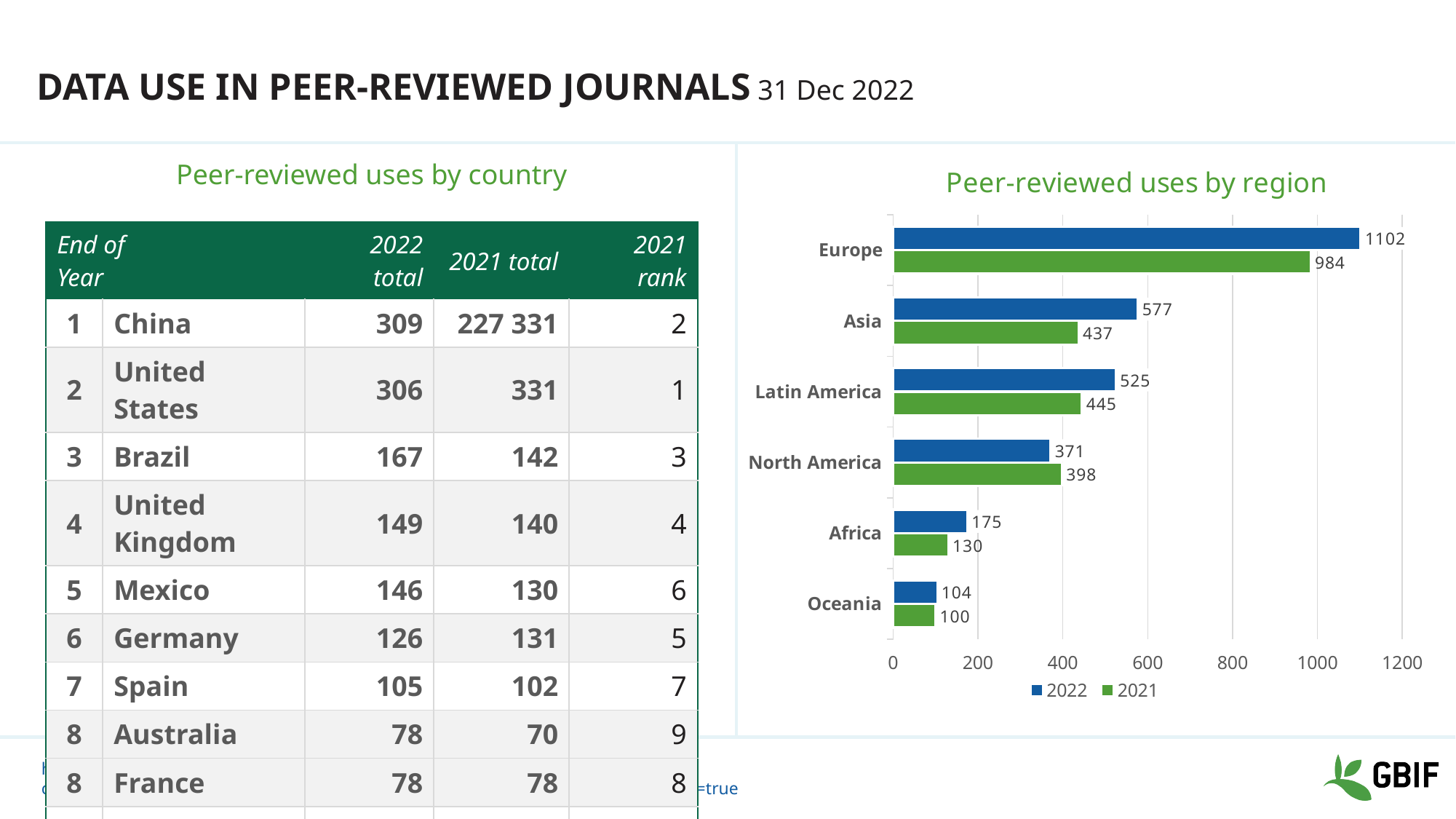
In the 'Peer-reviewed uses by region' chart, what is the 2021 value for Oceania? 100 In the 'Peer-reviewed uses by region' chart, is the 2022 value for Africa greater or less than 200? less In the 'Peer-reviewed uses by region' chart, what is the difference between the 2022 and 2021 values for Asia? 140 What kind of chart is 'Peer-reviewed uses by region'? Bar chart In the 'Peer-reviewed uses by region' chart, what is the 2022 value for Europe? 1102 How many regions are shown in the 'Peer-reviewed uses by region' chart? 6 How many series does the legend of the 'Peer-reviewed uses by region' chart list? 2 In the 'Peer-reviewed uses by region' chart, which is larger for North America: the 2022 value or the 2021 value? 2021 In the 'Peer-reviewed uses by region' chart, what is the 2021 value for Latin America? 445 In the 'Peer-reviewed uses by region' chart, which region has the lowest 2021 value? Oceania In the 'Peer-reviewed uses by region' chart, which region has the highest 2022 value? Europe In the 'Peer-reviewed uses by region' chart, which colour represents the 2021 series? Green